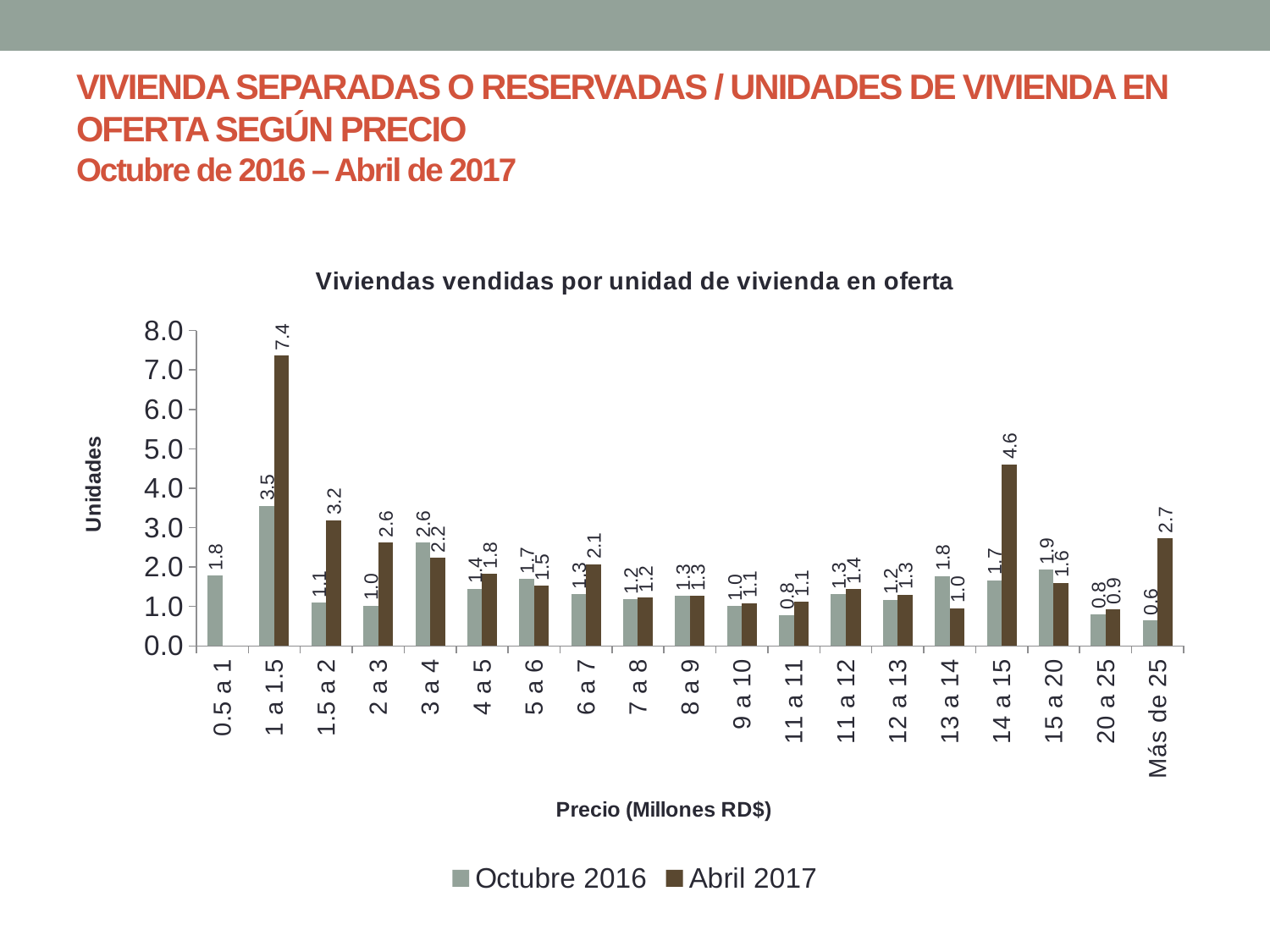
What is the value for Abril 2017 in the 14 a 15 price category? 4.6 Which price category has the lowest Octubre 2016 value? Más de 25 What kind of chart is shown on the slide? Bar chart What is the label of the x axis? Precio (Millones RD$) What is the difference between the Abril 2017 and Octubre 2016 values in the 1 a 1.5 price category? 3.9 What is the value for Octubre 2016 in the 3 a 4 price category? 2.6 How many price categories are shown on the x axis? 19 How many series does the legend list? 2 What is the value for Octubre 2016 in the Más de 25 price category? 0.6 Which price category has the highest Abril 2017 value? 1 a 1.5 In the 13 a 14 price category, which series has the larger value, Octubre 2016 or Abril 2017? Octubre 2016 What is the value for Abril 2017 in the 1 a 1.5 price category? 7.4